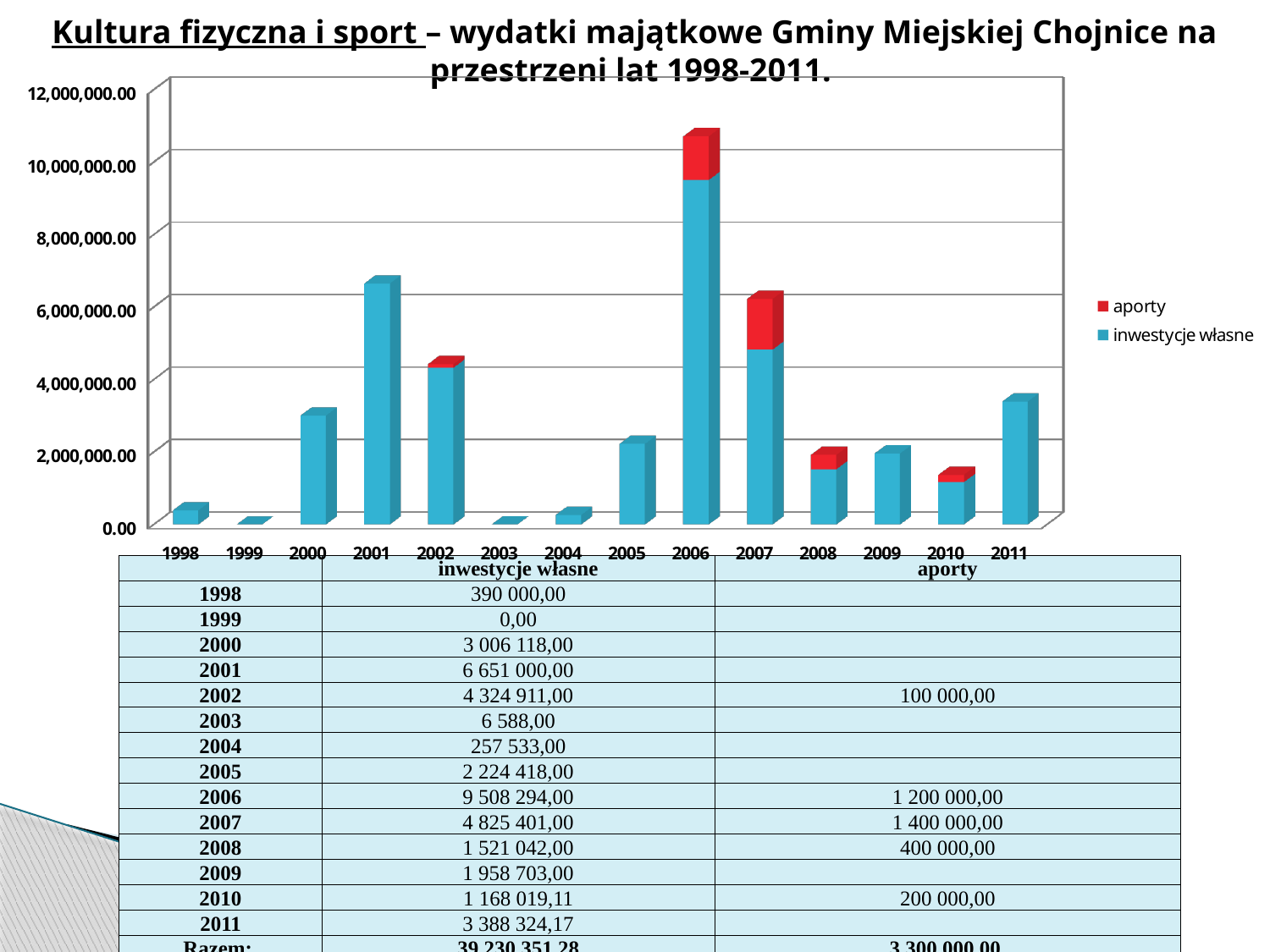
How many series does the chart legend list? 2 Which year has the lowest value for inwestycje własne? 1999 What is the value of aporty for 2007? 1 400 000,00 What is the difference between the aporty value for 2007 and the aporty value for 2006? 200 000,00 Is the value for 2011 greater or less than 2,000,000.00? greater What kind of chart is shown on the slide? bar chart Do the total bar values rise or fall from 2003 to 2006? rise Which year has the larger value for inwestycje własne, 2000 or 2005? 2000 What is the value of inwestycje własne for 2001? 6 651 000,00 How many years are shown on the x axis of the chart? 14 Which year has the highest total bar in the chart? 2006 What is the total of the stacked bar for 2006 (inwestycje własne plus aporty)? 10 708 294,00